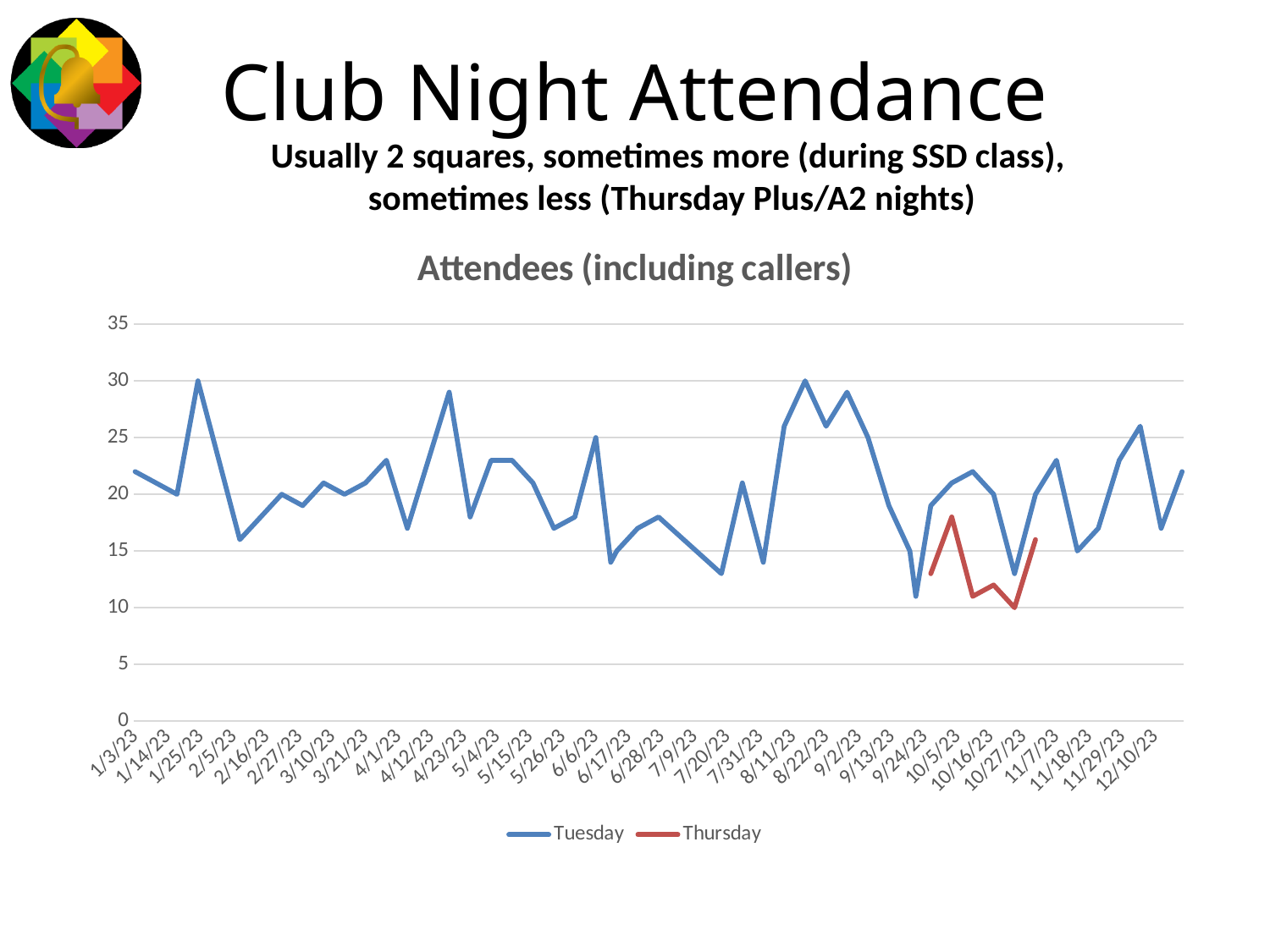
Which series is drawn in red? Thursday Is the lowest value of the Tuesday series greater or less than 15? less Is the lowest value of the Thursday series greater or less than 15? less Is the highest value of the Thursday series greater or less than 20? less Which series reaches the higher peak value, Tuesday or Thursday? Tuesday What is the highest value shown on the vertical axis? 35 Which series has the lower minimum value, Tuesday or Thursday? Thursday How many series does the legend list? 2 What kind of chart is shown on the slide? line chart What is the title of the chart? Attendees (including callers)